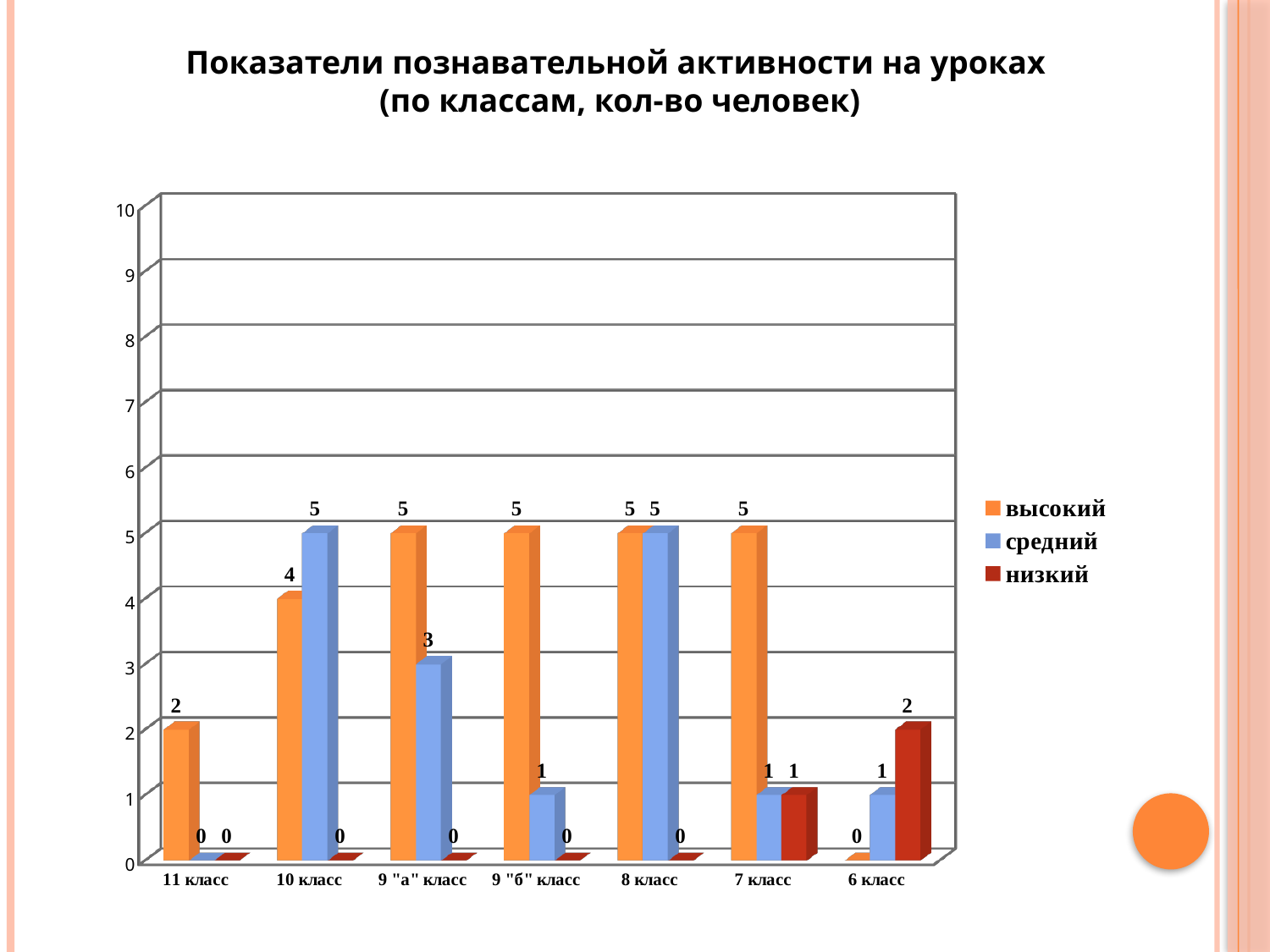
What is the value for низкий in 6 класс? 2 What is the value for средний in 10 класс? 5 Which colour represents the series низкий in the legend? dark red Which class has the highest value for низкий? 6 класс What is the difference between высокий and средний in 9 "б" класс? 4 Which is larger in 10 класс, высокий or средний? средний What kind of chart is shown on the slide? bar chart What is the value for высокий in 11 класс? 2 Which class has the lowest value for высокий? 6 класс How many series does the legend list? 3 How many classes are shown on the x axis? 7 What is the value for средний in 9 "а" класс? 3